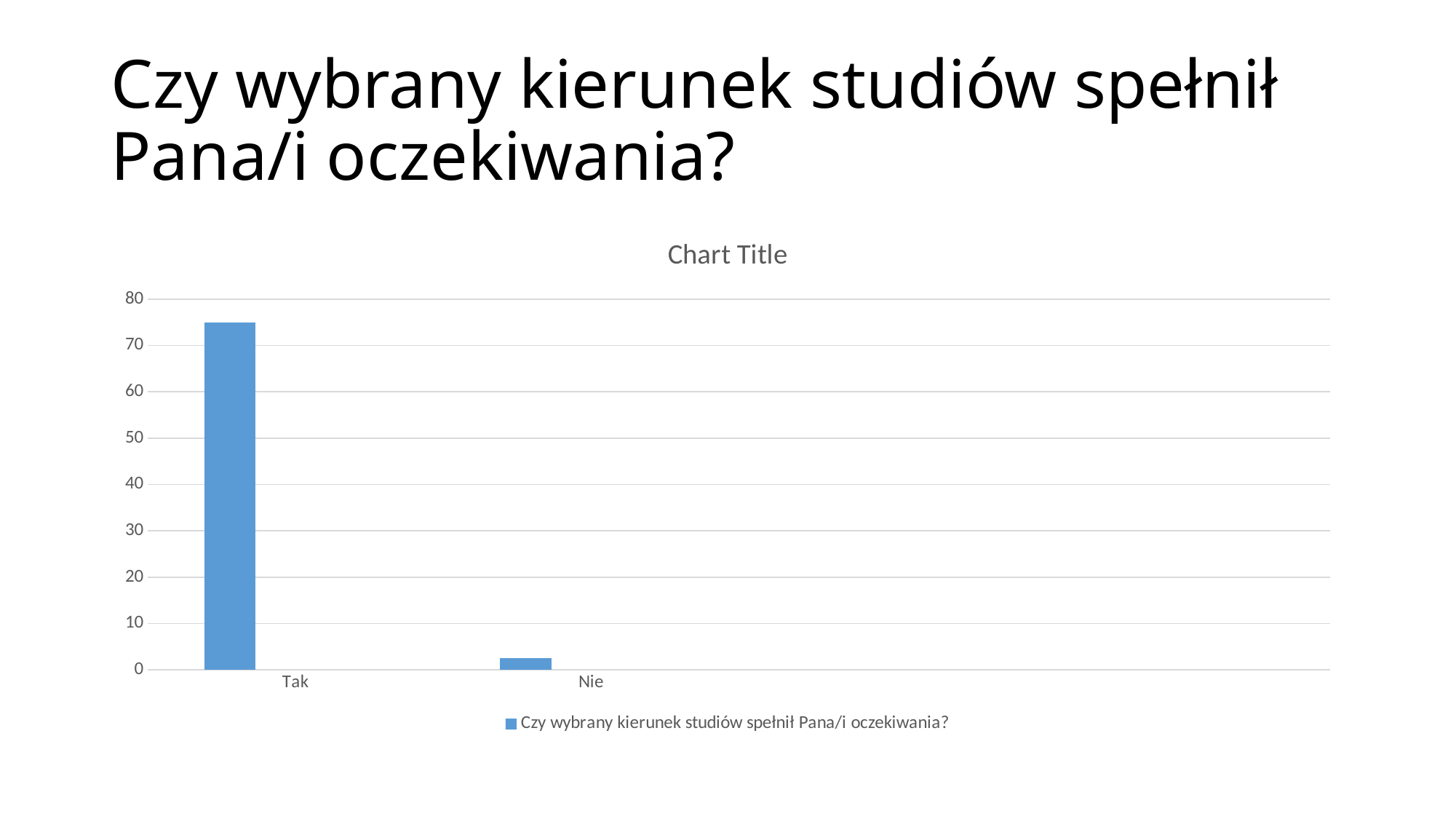
Is the value for Tak greater or less than 70? greater What is the legend entry of the series in the chart? Czy wybrany kierunek studiów spełnił Pana/i oczekiwania? Is the value for Nie greater or less than 10? less Which category has the highest value in the chart? Tak Which is larger, the value for Tak or the value for Nie? Tak What kind of chart is shown on the slide? bar chart What is the title shown above the chart? Chart Title Which category has the lowest value in the chart? Nie How many series does the chart legend list? 1 Is the value for Tak greater or less than 80? less How many categories are shown on the x axis of the chart? 2